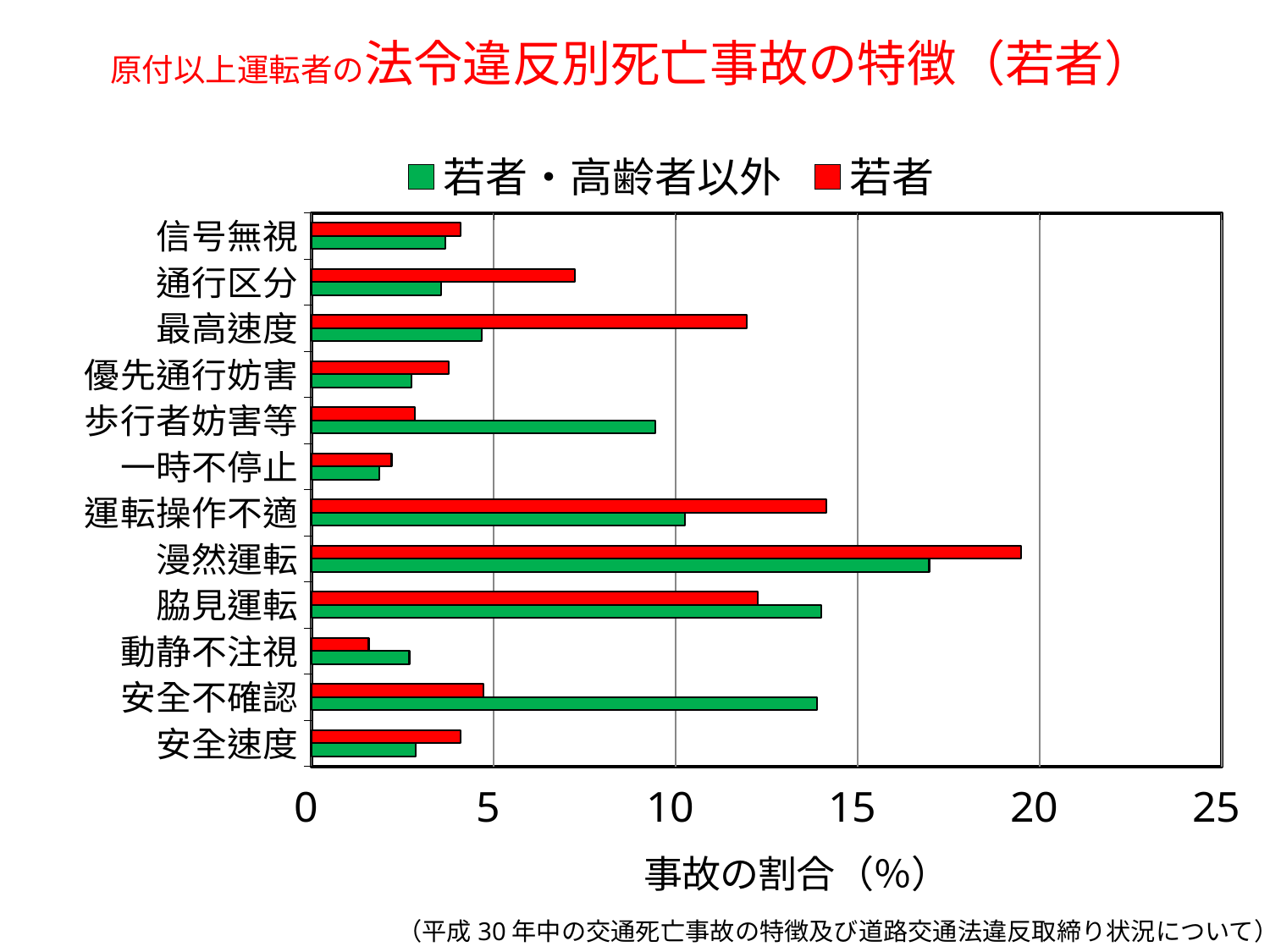
What kind of chart is shown on the slide? bar chart For 最高速度, which series has the larger value, 若者 or 若者・高齢者以外? 若者 Is the 若者 value for 動静不注視 greater or less than 5? less Which category has the highest value for the 若者 series? 漫然運転 Which category has the lowest value for the 若者・高齢者以外 series? 一時不停止 What colour represents the 若者 series in the chart? red Is the 若者・高齢者以外 value for 安全不確認 greater or less than 10? greater How many violation categories are plotted on the y axis? 12 For 歩行者妨害等, which series has the larger value, 若者 or 若者・高齢者以外? 若者・高齢者以外 Is the 若者 value for 漫然運転 greater or less than 15? greater Which category has the highest value for the 若者・高齢者以外 series? 漫然運転 How many series does the legend list? 2